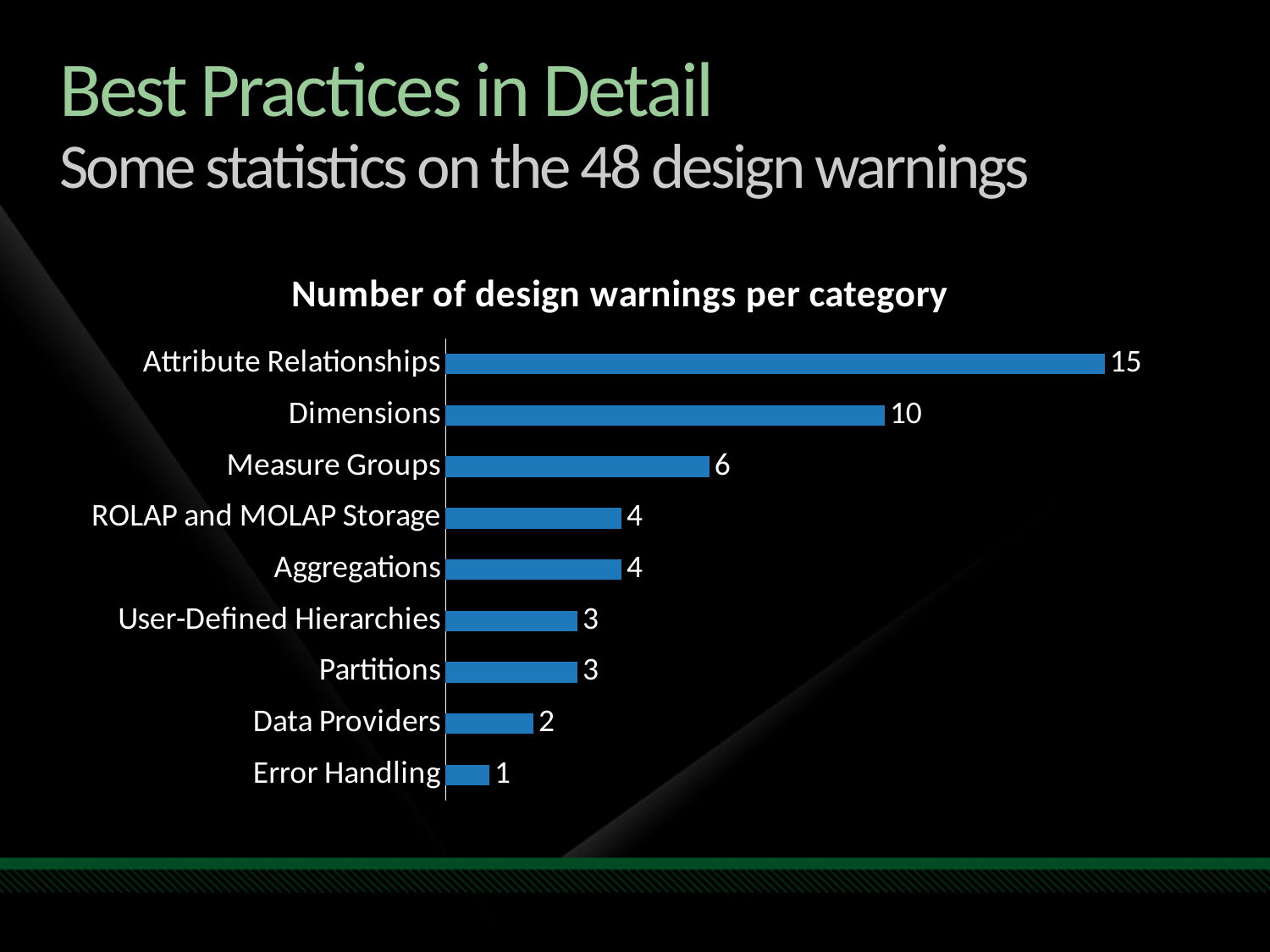
Which has more design warnings, Dimensions or Measure Groups? Dimensions What kind of chart is shown on the slide? Bar chart What is the difference between the number of design warnings for Measure Groups and Partitions? 3 Which category has the lowest number of design warnings? Error Handling Which category has the highest number of design warnings? Attribute Relationships What is the number of design warnings for Attribute Relationships? 15 What is the number of design warnings for Measure Groups? 6 What is the number of design warnings for Data Providers? 2 What is the difference between the number of design warnings for Attribute Relationships and Dimensions? 5 Which has more design warnings, User-Defined Hierarchies or Data Providers? User-Defined Hierarchies How many categories are shown in the chart? 9 What is the title of the chart? Number of design warnings per category